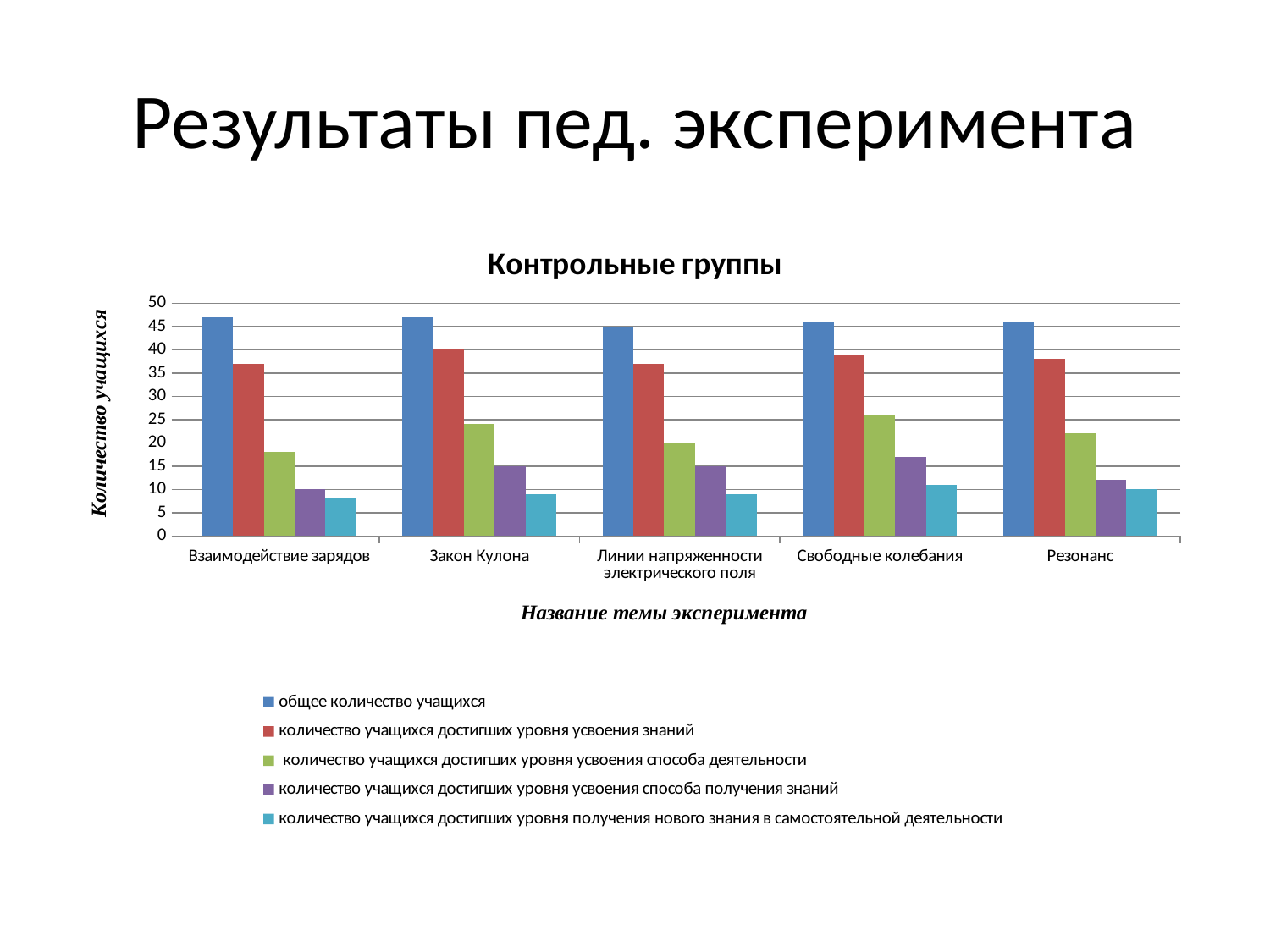
What is the value of 'количество учащихся достигших уровня усвоения знаний' for Закон Кулона? 40 Which topic has the highest value for 'количество учащихся достигших уровня усвоения способа деятельности'? Свободные колебания Which is larger for Закон Кулона: 'общее количество учащихся' or 'количество учащихся достигших уровня усвоения знаний'? общее количество учащихся How many categories (experiment topics) are shown on the x axis? 5 What is the value of 'количество учащихся достигших уровня усвоения способа деятельности' for Линии напряженности электрического поля? 20 How many series does the legend list? 5 What kind of chart is shown on the slide? bar chart What is the label of the vertical axis? Количество учащихся What is the title of the chart? Контрольные группы Is the value of 'количество учащихся достигших уровня получения нового знания в самостоятельной деятельности' for Взаимодействие зарядов greater or less than 10? less Is the value of 'общее количество учащихся' for Взаимодействие зарядов greater or less than 45? greater Is the value of 'количество учащихся достигших уровня усвоения знаний' for Резонанс greater or less than 40? less